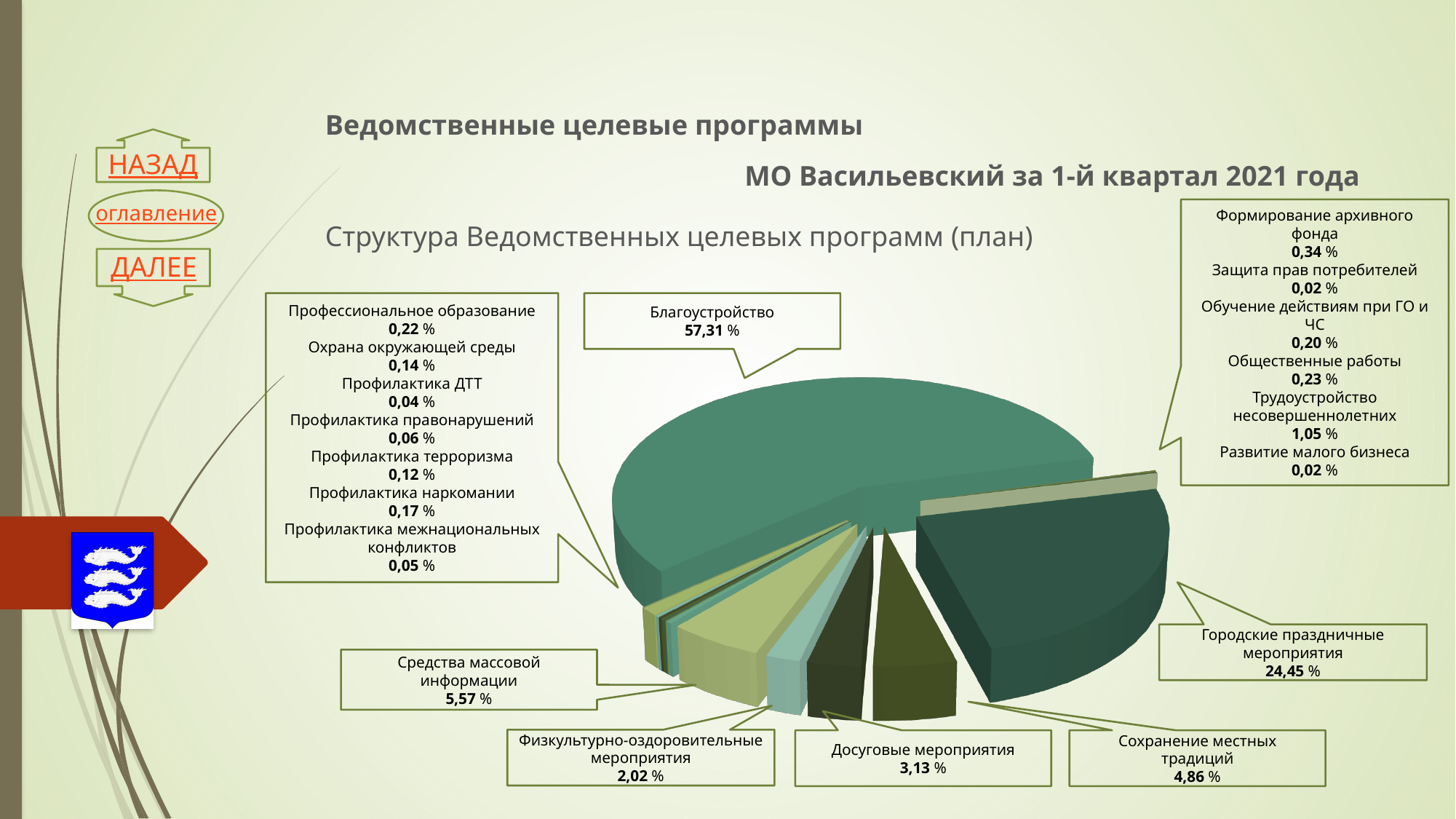
What is the difference between the shares of Благоустройство and Городские праздничные мероприятия? 32,86 % What is the value for Средства массовой информации? 5,57 % What is the title of the chart? Структура Ведомственных целевых программ (план) What is the value for Городские праздничные мероприятия? 24,45 % How many categories are labelled on the chart? 19 What is the value for Трудоустройство несовершеннолетних? 1,05 % What is the difference between Средства массовой информации and Физкультурно-оздоровительные мероприятия? 3,55 % Which category has the largest share of the pie? Благоустройство Which is larger: Сохранение местных традиций or Досуговые мероприятия? Сохранение местных традиций What type of chart is shown on the slide? Pie chart What share does Благоустройство have in the pie chart? 57,31 % What is the smallest share shown in the chart? 0,02 %